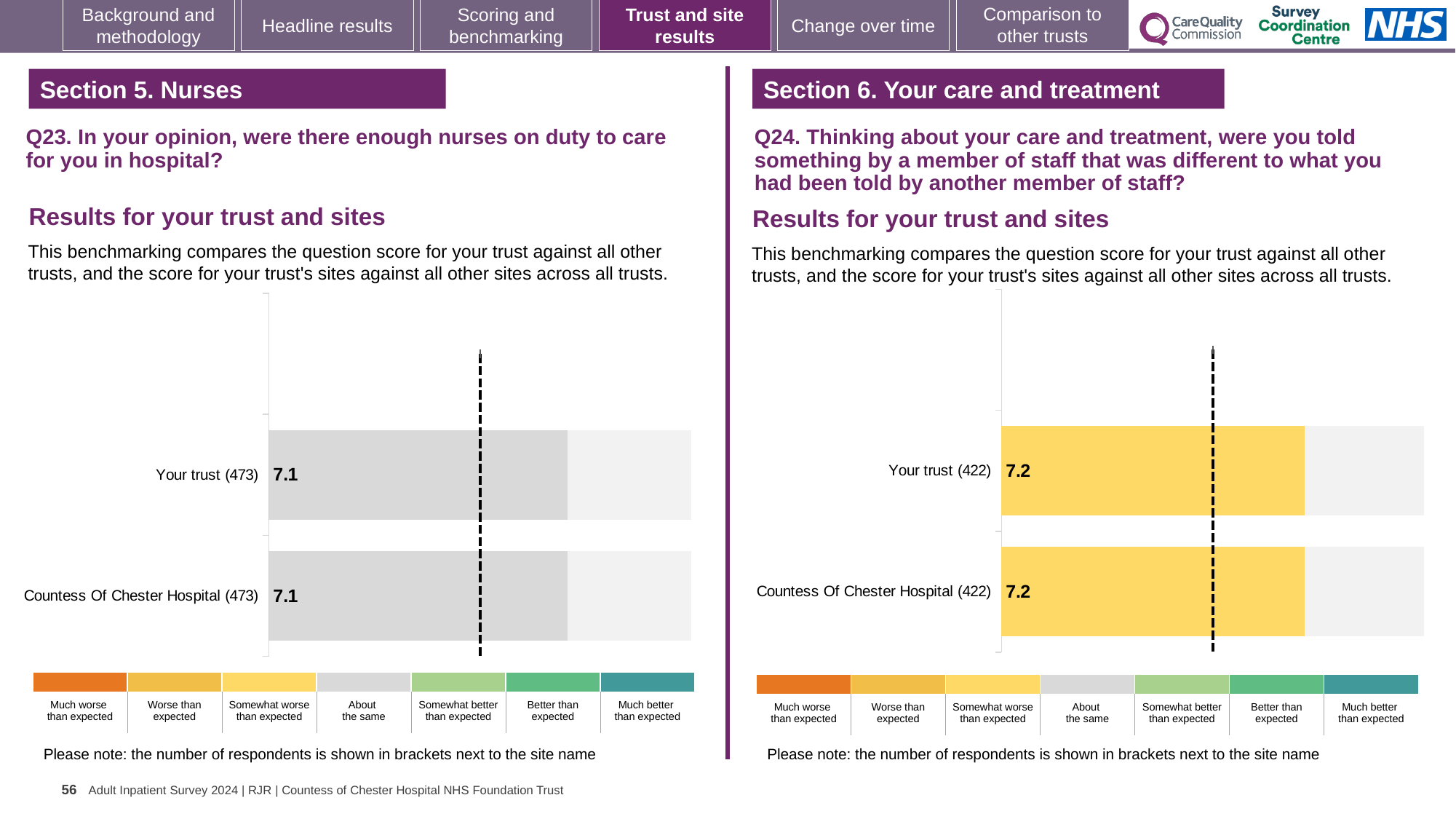
How many bars are plotted on the Q23 chart (left)? 2 How many bars are plotted on the Q24 chart (right)? 2 On the Q23 chart (left), what is the score for Countess Of Chester Hospital? 7.1 On the Q23 chart (left), what is the score for Your trust? 7.1 On the Q24 chart (right), what is the score for Countess Of Chester Hospital? 7.2 On the Q24 chart (right), how many respondents are shown in brackets next to Countess Of Chester Hospital? 422 Is the score for Your trust on the Q24 chart (right) larger or smaller than the score for Your trust on the Q23 chart (left)? Larger On the Q24 chart (right), what is the difference between the score for Your trust and the score for Countess Of Chester Hospital? 0 On the Q24 chart (right), what is the score for Your trust? 7.2 What kind of chart is used for the Q24 results (right)? Bar chart On the Q23 chart (left), how many respondents are shown in brackets next to Your trust? 473 On the Q23 chart (left), what is the difference between the score for Your trust and the score for Countess Of Chester Hospital? 0